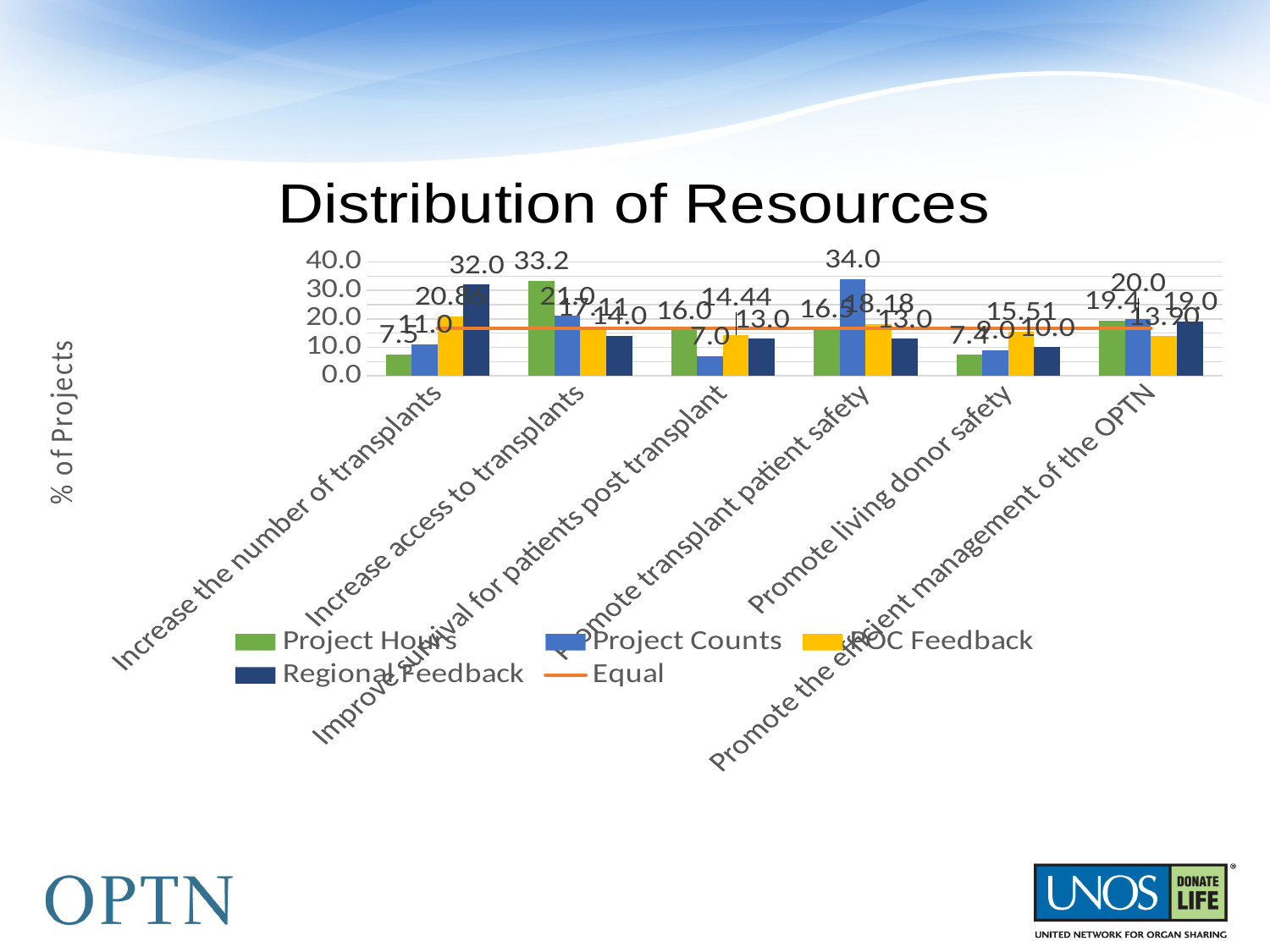
Which is larger: the Regional Feedback value for 'Increase the number of transplants' or for 'Promote living donor safety'? Increase the number of transplants What is the difference between the Regional Feedback value (32.0) and the Project Hours value (7.5) for 'Increase the number of transplants'? 24.5 What is the Regional Feedback value for 'Increase the number of transplants'? 32.0 What is the Project Hours value for 'Increase access to transplants'? 33.2 What is the Project Counts value for 'Improve survival for patients post transplant'? 7.0 What is the Project Counts value for 'Promote transplant patient safety'? 34.0 Which category has the highest Project Counts value? Promote transplant patient safety Which category has the highest Regional Feedback value? Increase the number of transplants What is the label on the vertical axis of the chart? % of Projects How many entries does the legend list? 5 What is the POC Feedback value for 'Promote living donor safety'? 15.51 How many categories are shown on the x axis? 6